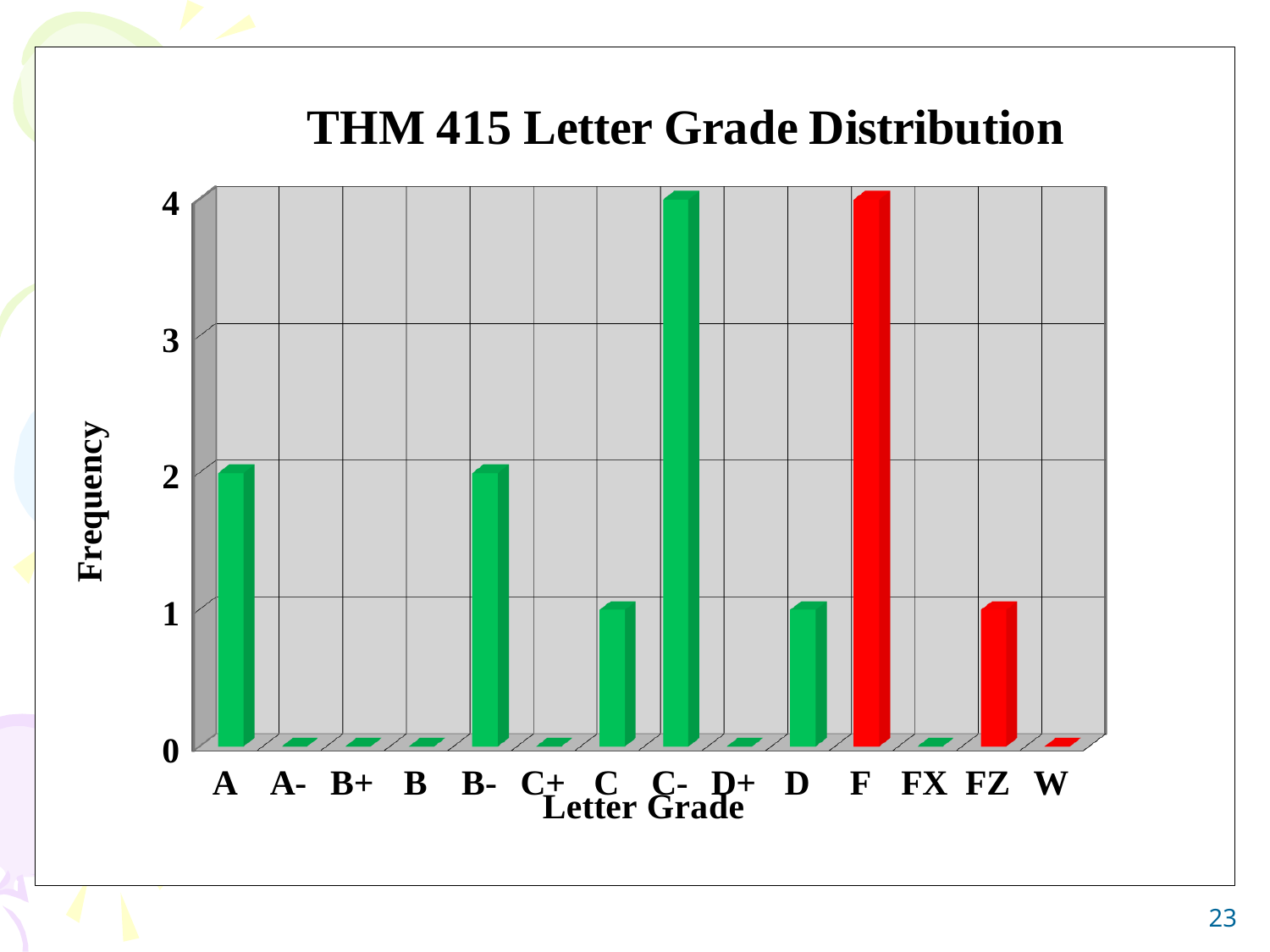
What is the frequency for grade F? 4 What is the frequency for grade FZ? 1 Which two grades share the highest frequency? C- and F Which has the larger frequency, grade A or grade C? A What is the title of the chart? THM 415 Letter Grade Distribution What is the frequency for grade A? 2 What is the frequency for grade C-? 4 What is the frequency for grade B-? 2 What kind of chart is shown on the slide? Bar chart What is the frequency for grade B+? 0 How many letter grade categories are shown on the x axis? 14 What is the difference between the frequency for C- and the frequency for A? 2